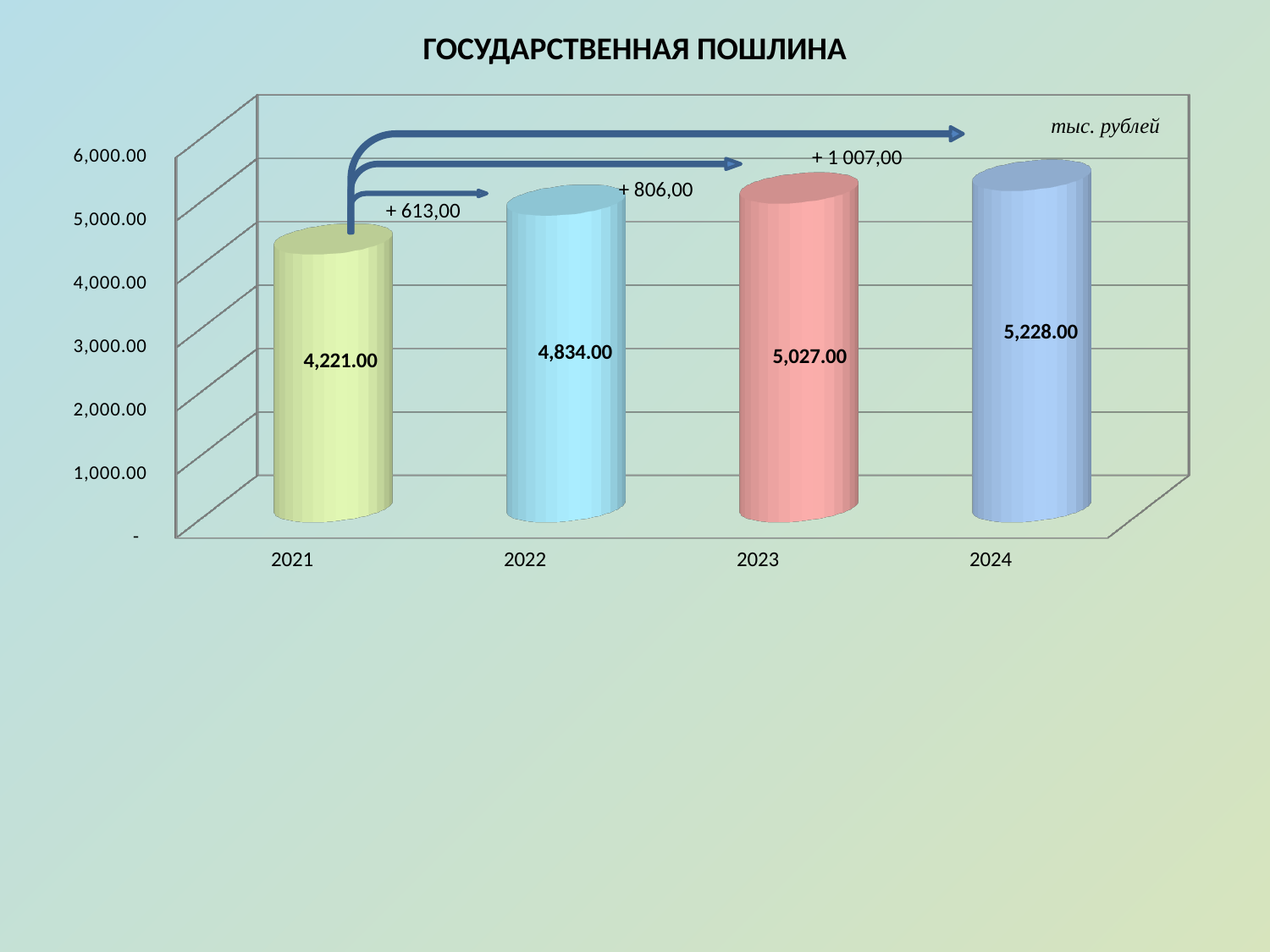
What is the value for 2021 in the chart? 4,221.00 What is the value for 2023 in the chart? 5,027.00 Which is larger, the value for 2022 or the value for 2023? 2023 What kind of chart is shown on the slide? bar chart Which year has the lowest value? 2021 Is the value for 2021 greater or less than 5,000.00? less What is the difference between the values for 2022 and 2021? 613.00 What is the value for 2024 in the chart? 5,228.00 How many years are shown on the x axis? 4 Which year has the highest value? 2024 Do the values rise or fall from 2021 to 2024? rise What is the difference between the values for 2024 and 2023? 201.00